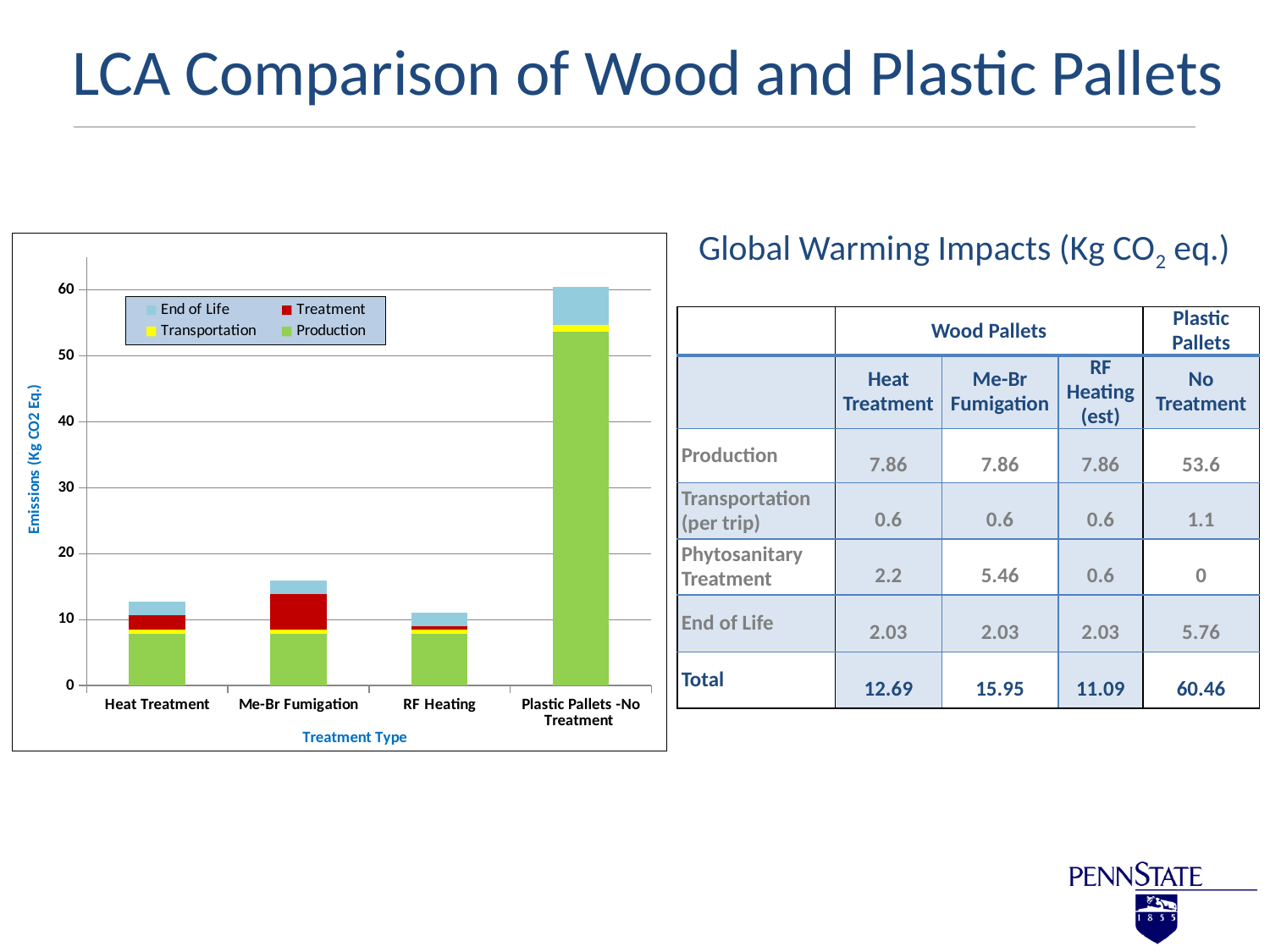
Which colour represents Production in the chart's legend? Green How many series does the chart's legend list? 4 Which treatment type has the highest total emissions in the chart? Plastic Pallets - No Treatment What kind of chart is shown on the slide? Stacked bar chart Which has a taller total bar in the chart, Me-Br Fumigation or Heat Treatment? Me-Br Fumigation According to the slide, what is the total emissions value for Plastic Pallets - No Treatment? 60.46 Is the total bar height for Heat Treatment greater or less than 20? less Is the total bar height for Me-Br Fumigation greater or less than 10? greater Is the total bar height for Plastic Pallets - No Treatment greater or less than 50? greater How many treatment types are shown on the x axis of the chart? 4 Which treatment type has the lowest total emissions in the chart? RF Heating What is the title of the chart's y axis? Emissions (Kg CO2 Eq.)